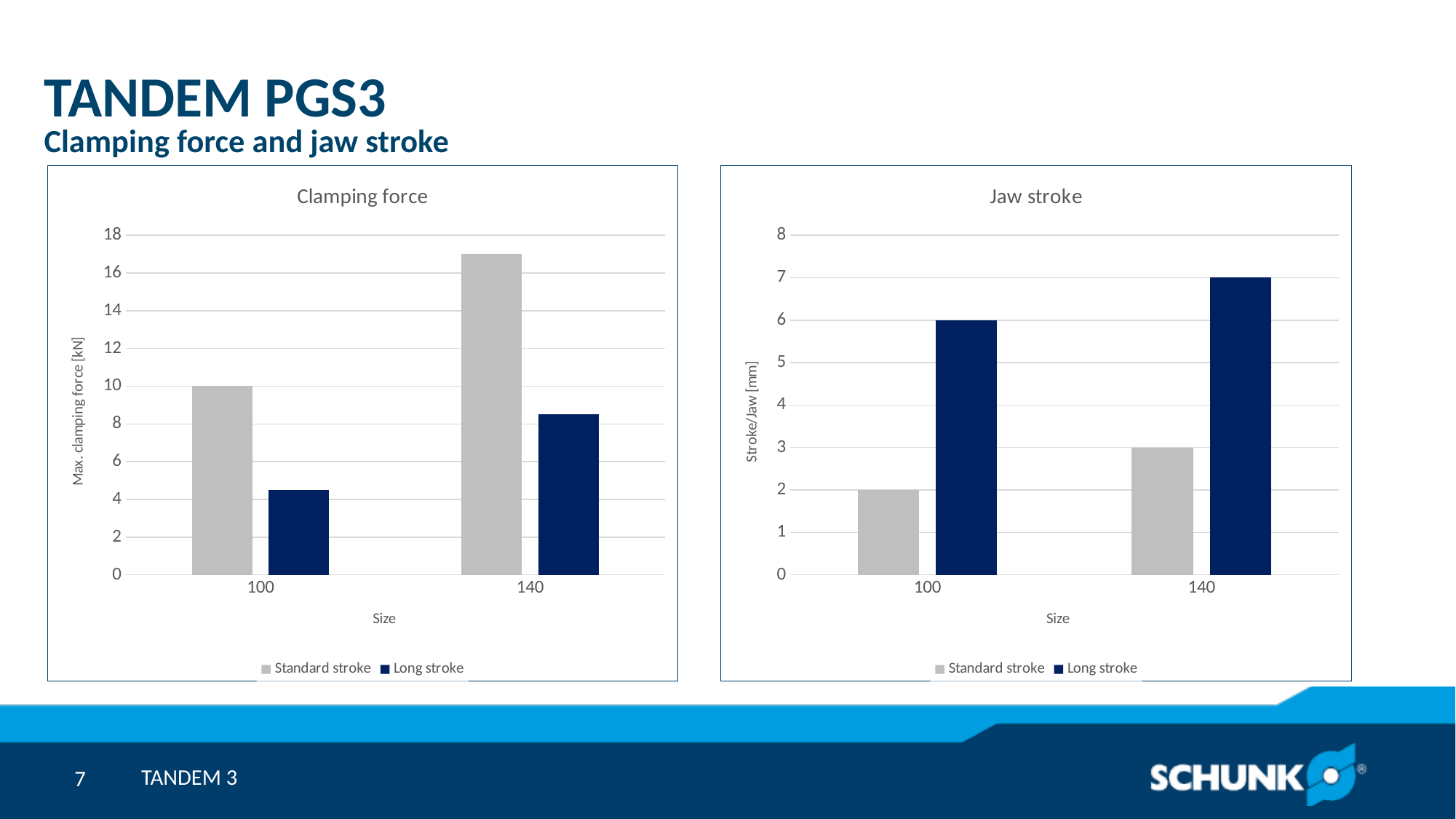
What is the y-axis label of the Jaw stroke chart? Stroke/Jaw [mm] In the Jaw stroke chart, what is the value for Long stroke at size 140? 7 In the Jaw stroke chart, what is the difference between Long stroke and Standard stroke at size 100? 4 In the Jaw stroke chart, which bar is the lowest? Standard stroke at size 100 What kind of chart is the Clamping force chart? Bar chart In the Clamping force chart, is the value for Long stroke at size 100 greater or less than 6? less In the Clamping force chart, which bar is the highest? Standard stroke at size 140 In the Jaw stroke chart, what is the value for Standard stroke at size 100? 2 In the Clamping force chart, is the value for Standard stroke at size 140 greater or less than 16? greater In the Jaw stroke chart, how many series does the legend list? 2 In the Clamping force chart, what is the value for Standard stroke at size 100? 10 In the Clamping force chart, which size has the higher Long stroke value, 100 or 140? 140